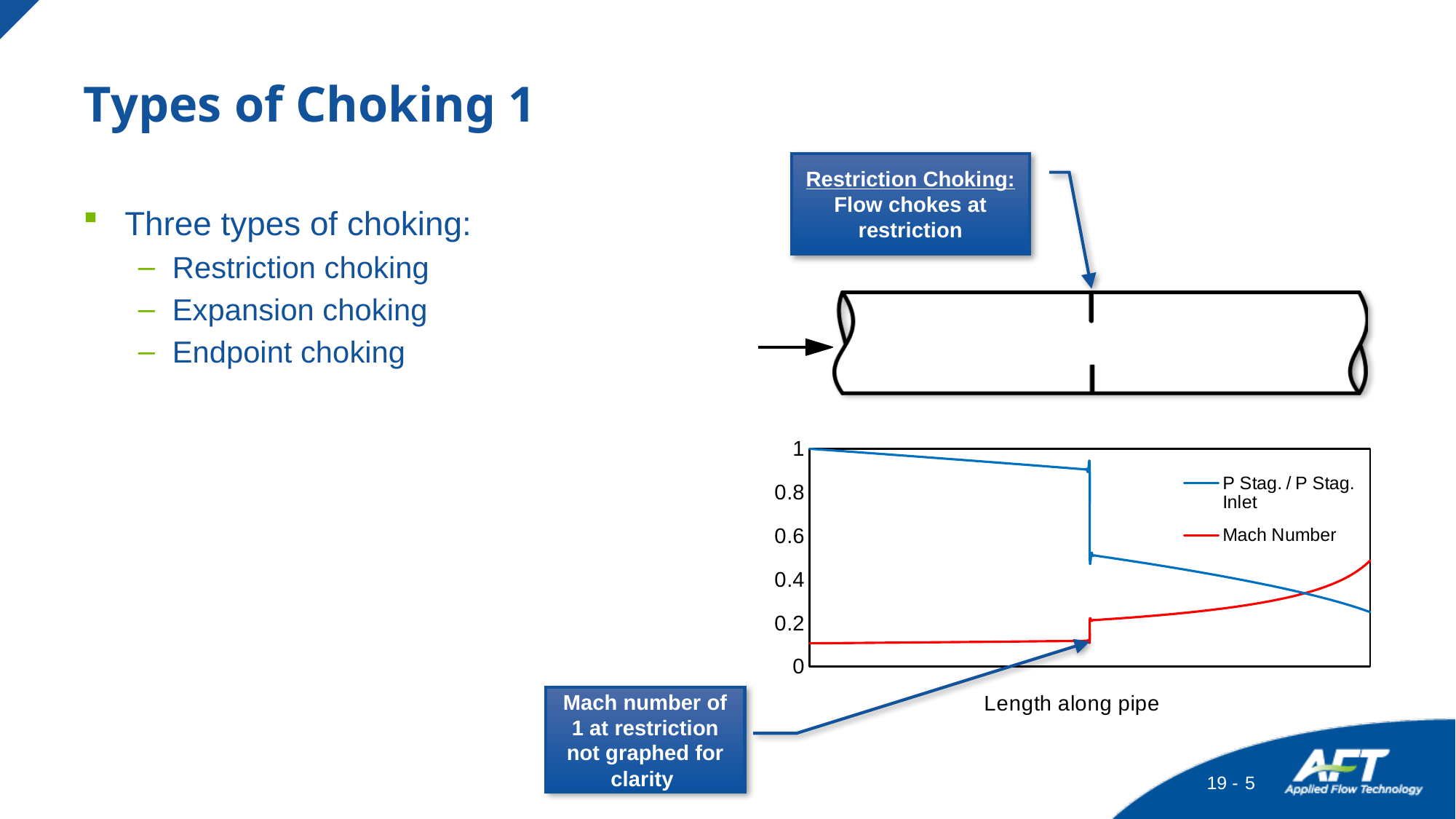
Is the Mach Number at the inlet (left end) greater or less than 0.2? less Is P Stag. / P Stag. Inlet at the right end of the pipe greater or less than 0.4? less What kind of chart is shown on the slide? line chart Is the Mach Number at the right end of the pipe greater or less than 0.4? greater What is the title of the chart's x axis? Length along pipe At the right end of the pipe, which series has the higher value, Mach Number or P Stag. / P Stag. Inlet? Mach Number What is the value of P Stag. / P Stag. Inlet at the inlet (left end of the chart)? 1 What are the two series named in the chart's legend? P Stag. / P Stag. Inlet and Mach Number Does P Stag. / P Stag. Inlet rise or fall along the length of the pipe? fall How many series does the chart's legend list? 2 Does the Mach Number rise or fall along the length of the pipe? rise